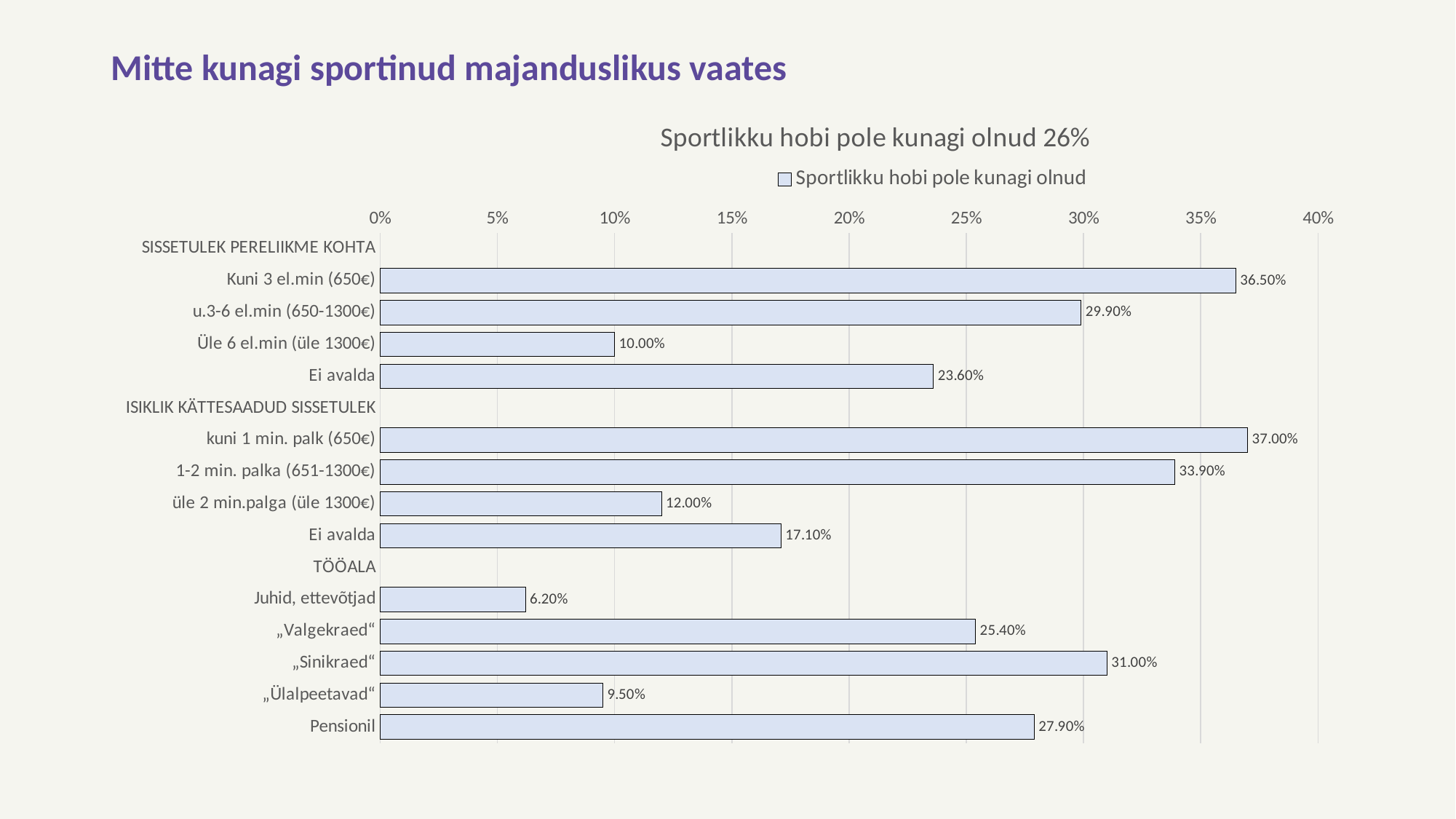
What is the value for Ei avalda under ISIKLIK KÄTTESAADUD SISSETULEK? 17.10% How many bars are plotted in the chart? 13 Is the value for 1-2 min. palka (651-1300€) greater or less than 30%? greater What is the difference between the values for „Sinikraed“ and „Valgekraed“? 5.60% Which category has the lowest value? Juhid, ettevõtjad Which is larger, the value for Pensionil or the value for u.3-6 el.min (650-1300€)? u.3-6 el.min (650-1300€) What kind of chart is shown on the slide? bar chart How many series does the legend list? 1 Which category has the highest value? kuni 1 min. palk (650€) What is the value for Kuni 3 el.min (650€)? 36.50% What is the value for „Sinikraed“? 31.00% What is the title of the chart? Sportlikku hobi pole kunagi olnud 26%